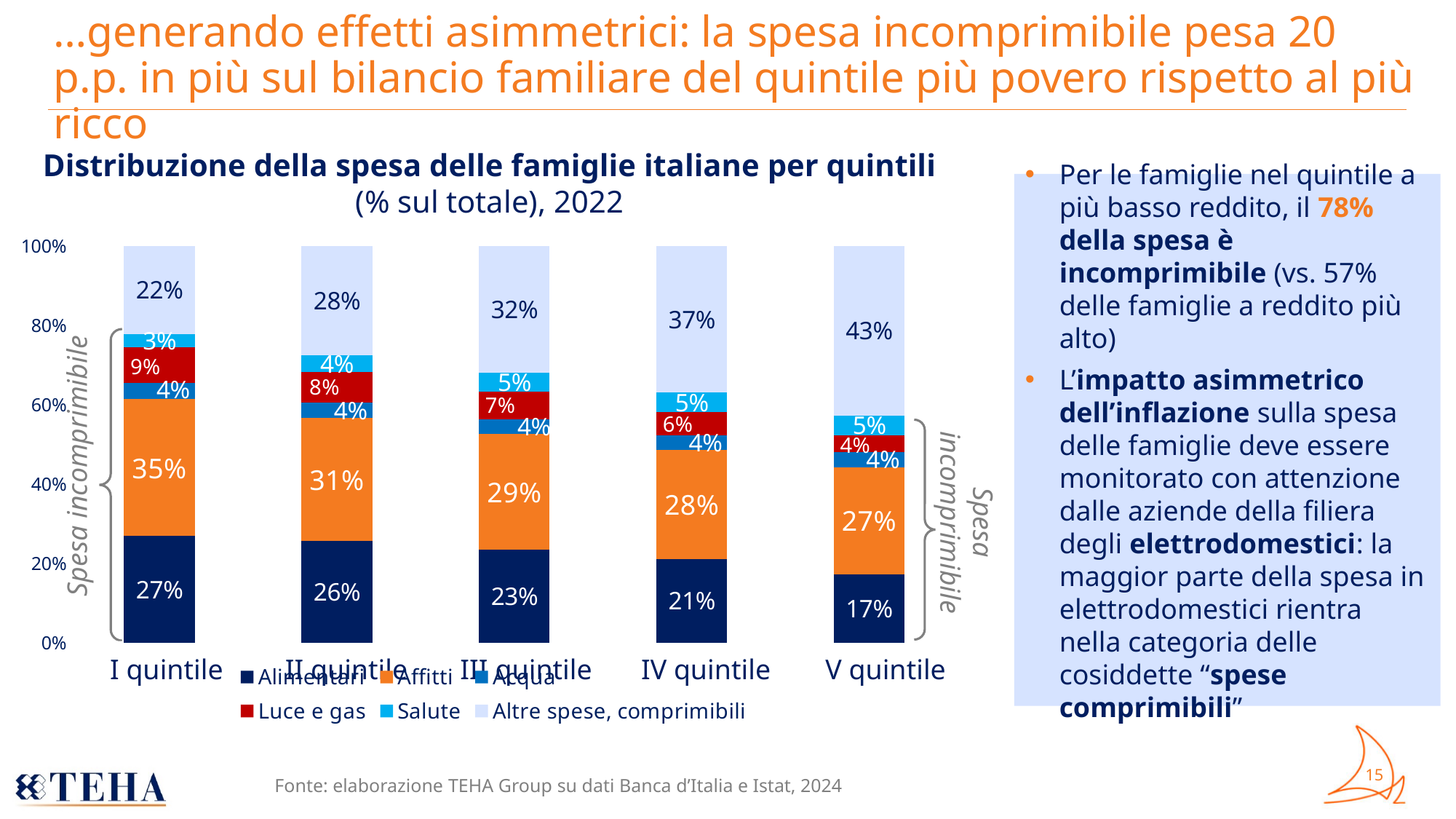
Which quintile has the highest 'Altre spese, comprimibili' share? V quintile Which quintile has the lowest Alimentari share? V quintile What is the Affitti share for the V quintile? 27% What is the Alimentari share for the I quintile? 27% What is the difference between the 'Altre spese, comprimibili' share of the V quintile and that of the I quintile? 21 percentage points How many quintile categories are shown on the x axis? 5 Is the Luce e gas share larger for the I quintile or the V quintile? I quintile What is the Luce e gas share for the II quintile? 8% What is the 'Altre spese, comprimibili' share for the IV quintile? 37% What kind of chart is shown on the slide? Stacked bar chart How does the Alimentari share change from the I quintile to the V quintile? It falls How many series does the legend list? 6